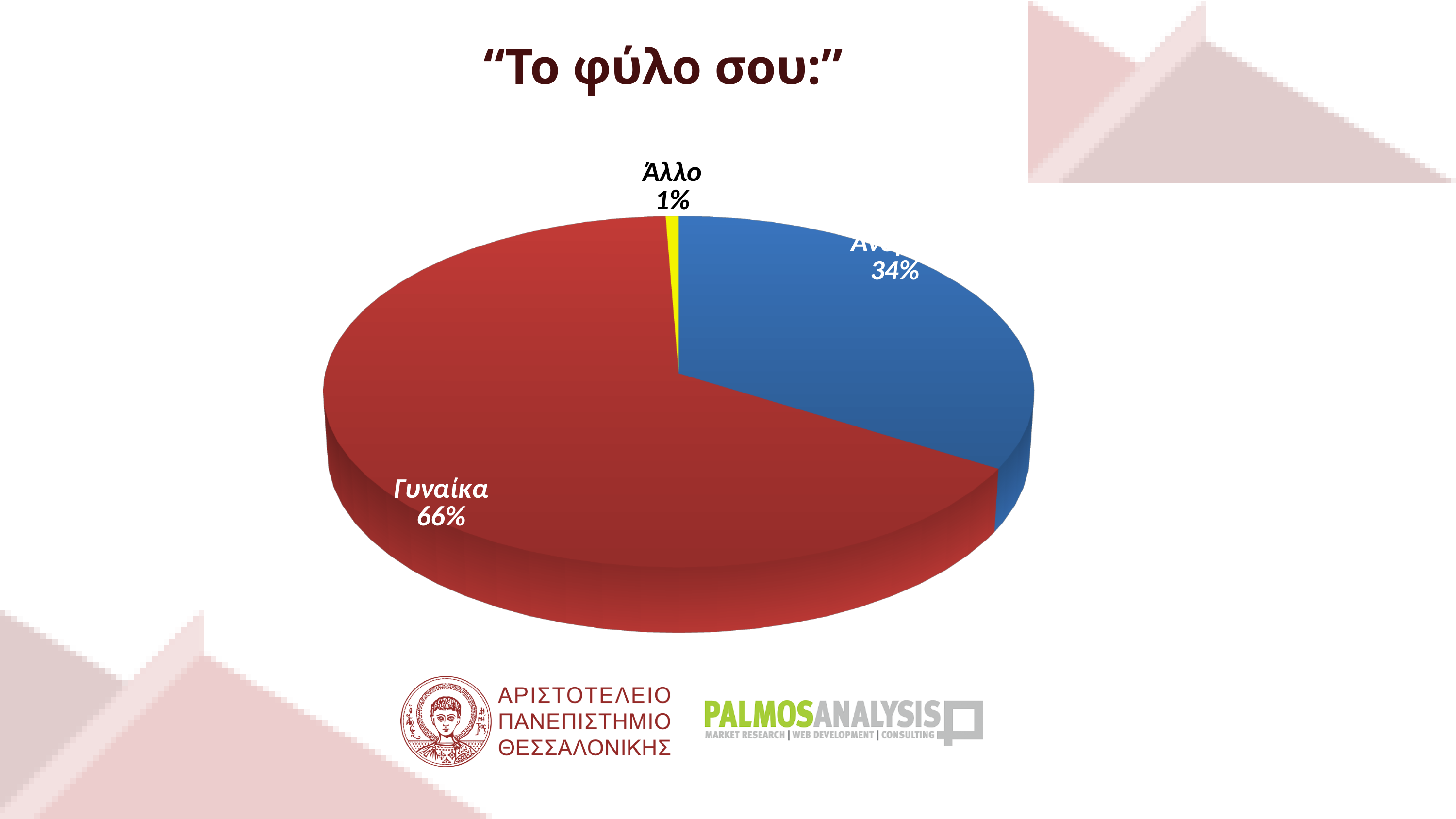
How many slices does the pie chart have? 3 What percentage is shown on the blue slice of the pie? 34% What is the title of the chart? "Το φύλο σου:" Which is larger, the Γυναίκα slice or the blue slice? Γυναίκα What is the difference in percentage points between the Γυναίκα slice and the Άλλο slice? 65 What colour is the Γυναίκα slice? red What percentage of the pie is labelled Γυναίκα? 66% What kind of chart is shown on the slide? pie chart Which slice of the pie is the smallest? Άλλο What percentage of the pie is labelled Άλλο? 1% Which slice of the pie is the largest? Γυναίκα What is the difference in percentage points between the Γυναίκα slice and the blue slice? 32